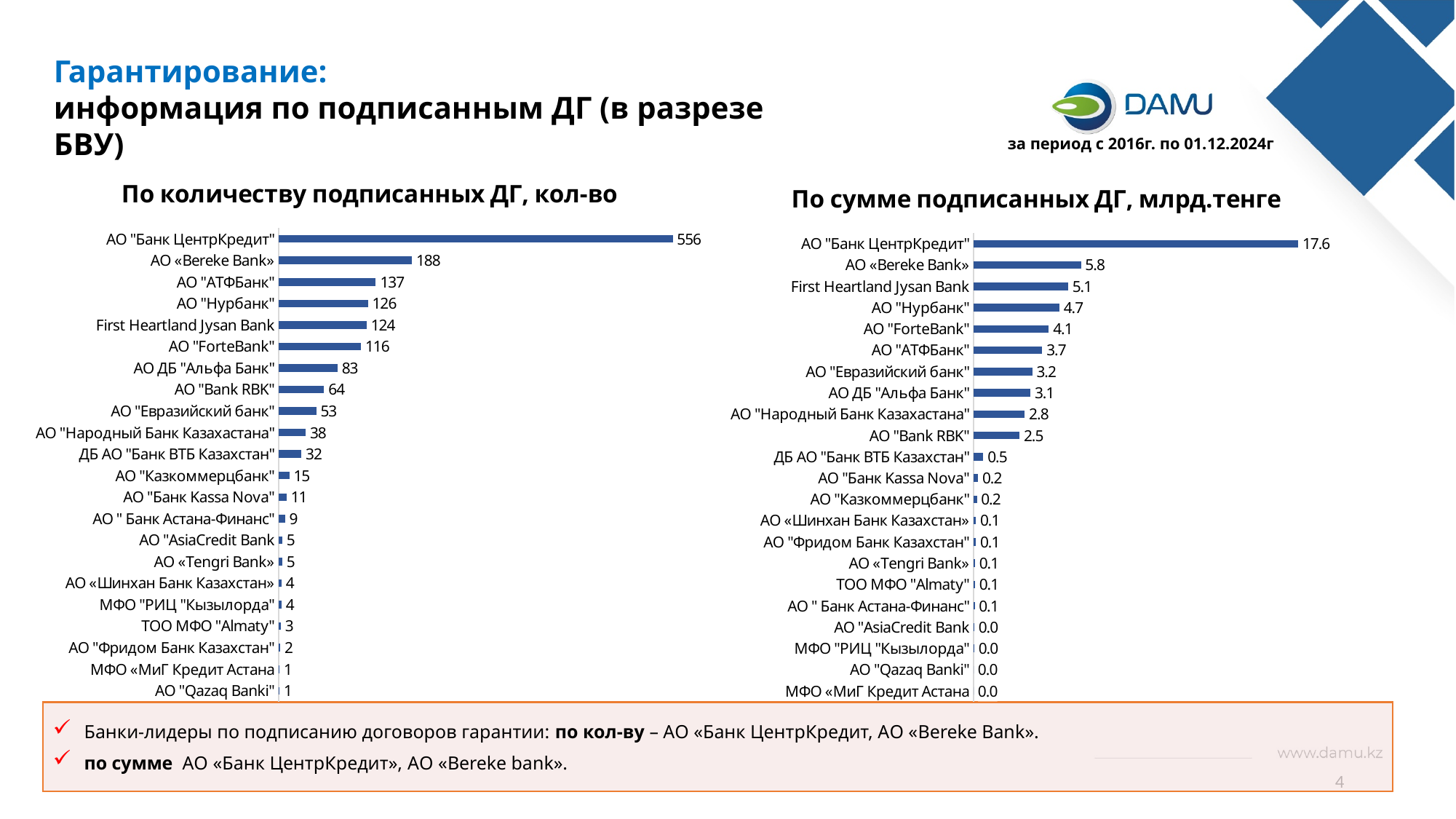
In the chart "По количеству подписанных ДГ, кол-во", what is the difference between АО «Bereke Bank» and АО "АТФБанк"? 51 In the chart "По сумме подписанных ДГ, млрд.тенге", what is the value for First Heartland Jysan Bank? 5.1 In the chart "По количеству подписанных ДГ, кол-во", which is larger: АО ДБ "Альфа Банк" or АО "Bank RBK"? АО ДБ "Альфа Банк" In the chart "По сумме подписанных ДГ, млрд.тенге", which bank has the highest value? АО "Банк ЦентрКредит" In the chart "По количеству подписанных ДГ, кол-во", what is the value for АО "Банк ЦентрКредит"? 556 What type of chart is "По сумме подписанных ДГ, млрд.тенге"? Bar chart How many banks are listed in the chart "По количеству подписанных ДГ, кол-во"? 22 In the chart "По сумме подписанных ДГ, млрд.тенге", what is the value for АО "Народный Банк Казахастана"? 2.8 In the chart "По сумме подписанных ДГ, млрд.тенге", which is larger: АО "АТФБанк" or АО "ForteBank"? АО "ForteBank" In the chart "По количеству подписанных ДГ, кол-во", which bank has the highest value? АО "Банк ЦентрКредит" In the chart "По количеству подписанных ДГ, кол-во", what is the value for АО "ForteBank"? 116 In the chart "По сумме подписанных ДГ, млрд.тенге", what is the difference between АО "Банк ЦентрКредит" and АО «Bereke Bank»? 11.8